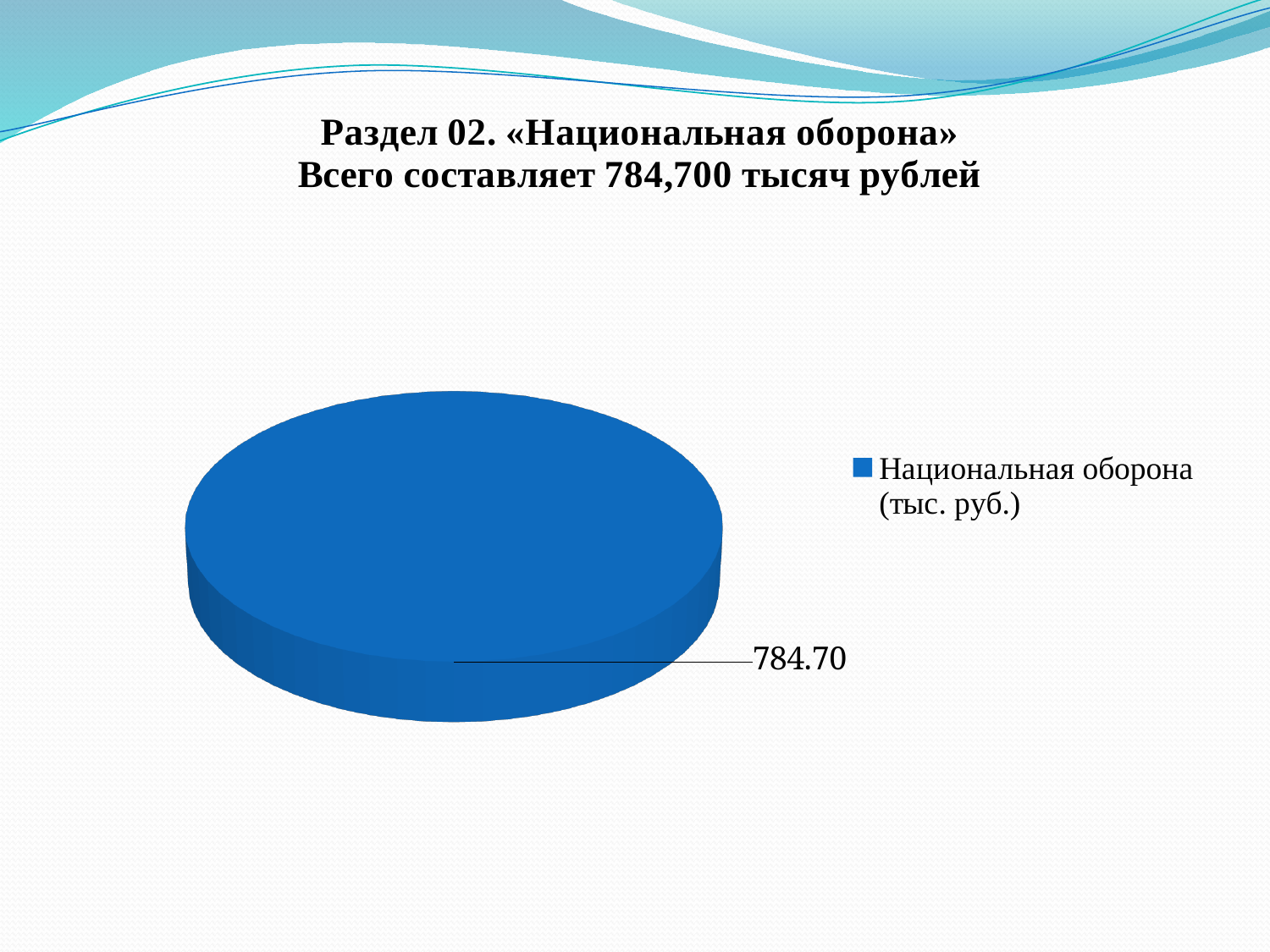
What colour is the pie slice? blue Is the value labelled on the pie slice greater or less than 700? greater How many entries does the legend list? 1 What value is labelled on the pie slice for Национальная оборона (тыс. руб.)? 784.70 What is the legend entry shown next to the pie chart? Национальная оборона (тыс. руб.) What share of the pie does the Национальная оборона (тыс. руб.) slice take up? 100% What kind of chart is shown on the slide? pie chart How many slices does the pie chart have? 1